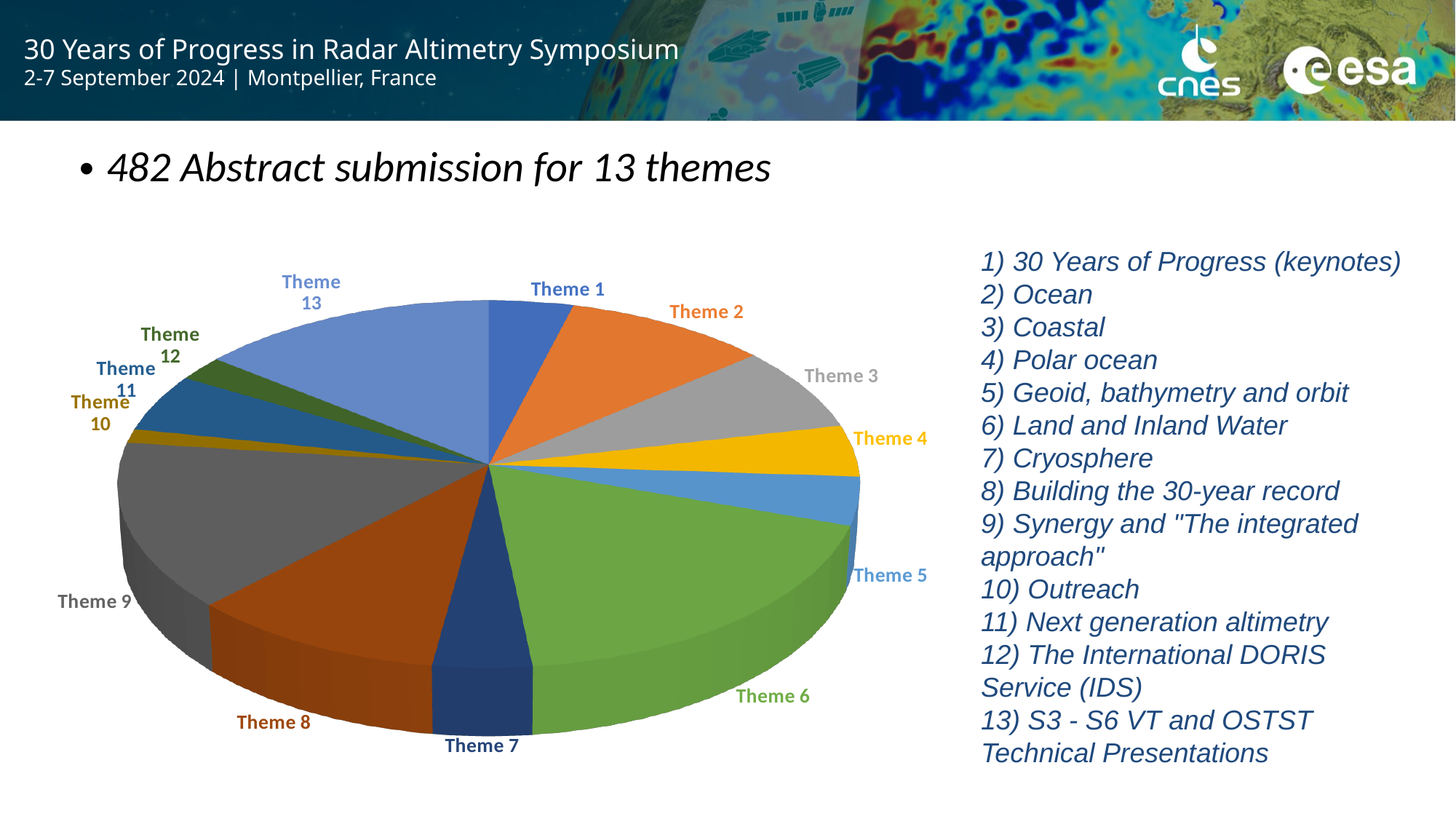
What kind of chart is shown on the slide? pie chart What colour is the slice for Theme 6 in the pie chart? green According to the list on the slide, what topic does Theme 2 correspond to? Ocean Which slice is larger, Theme 2 or Theme 11? Theme 2 How many themes (slices) does the pie chart show? 13 Which slice is larger, Theme 6 or Theme 4? Theme 6 Which slice is larger, Theme 8 or Theme 10? Theme 8 Which theme has the largest slice in the pie chart? Theme 6